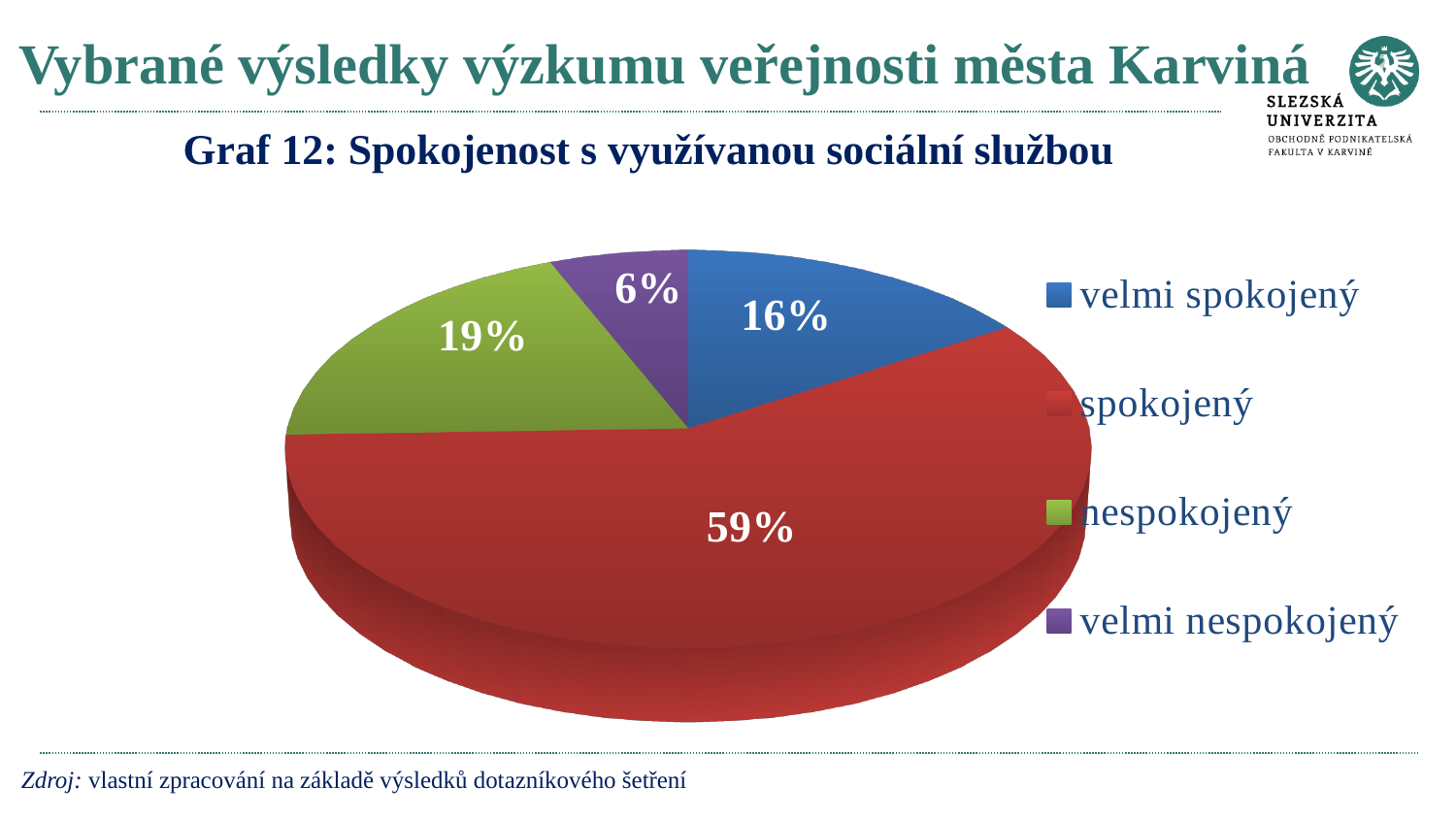
What share of the pie does "velmi spokojený" represent? 16% How many categories does the pie chart show? 4 Which is larger, the share for "nespokojený" or the share for "velmi spokojený"? nespokojený What is the title of the chart? Graf 12: Spokojenost s využívanou sociální službou What share of the pie does "spokojený" represent? 59% Which category has the smallest share of the pie? velmi nespokojený What is the difference in percentage points between "spokojený" and "nespokojený"? 40 What share of the pie does "nespokojený" represent? 19% What share of the pie does "velmi nespokojený" represent? 6% What kind of chart is shown on the slide? pie chart What is the combined share of "velmi spokojený" and "spokojený"? 75% Which category has the largest share of the pie? spokojený